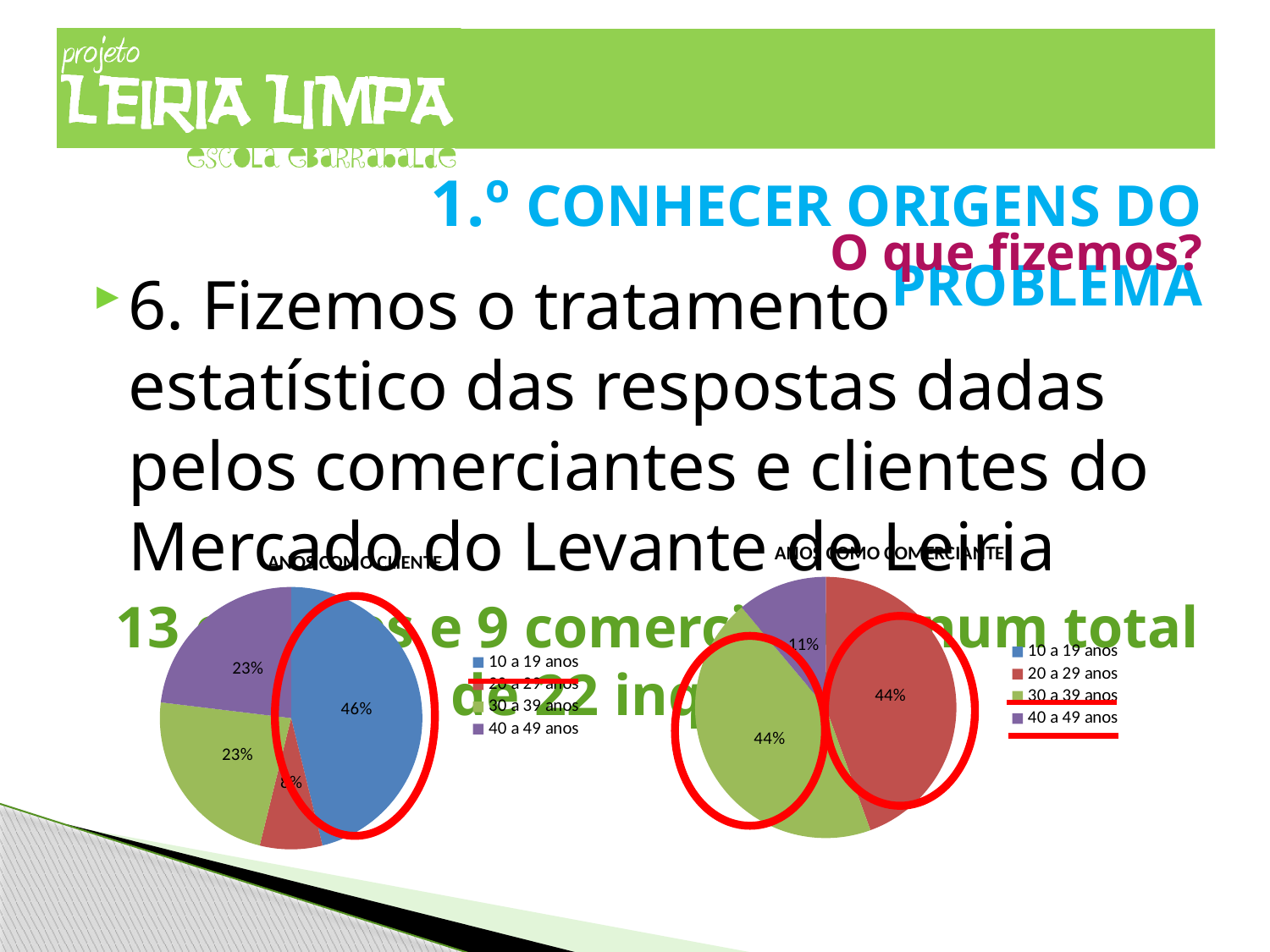
How many entries does the legend of the right pie chart list? 4 What kind of chart is the chart on the left of the slide? pie chart In the left pie chart, what percentage is shown for the 10 a 19 anos slice? 46% In the left pie chart, which slice is larger: 10 a 19 anos or 40 a 49 anos? 10 a 19 anos In the right pie chart, which category has the smallest slice? 40 a 49 anos In the left pie chart, which category has the smallest slice? 20 a 29 anos In the right pie chart, what percentage is shown for the 40 a 49 anos slice? 11% In the right pie chart, what is the difference in percentage points between the 30 a 39 anos slice and the 40 a 49 anos slice? 33 percentage points In the left pie chart, what is the difference in percentage points between the 10 a 19 anos slice and the 20 a 29 anos slice? 38 percentage points In the left pie chart, which category has the largest slice? 10 a 19 anos In the right pie chart, which slice is larger: 20 a 29 anos or 40 a 49 anos? 20 a 29 anos In the left pie chart, what percentage is shown for the 30 a 39 anos slice? 23%